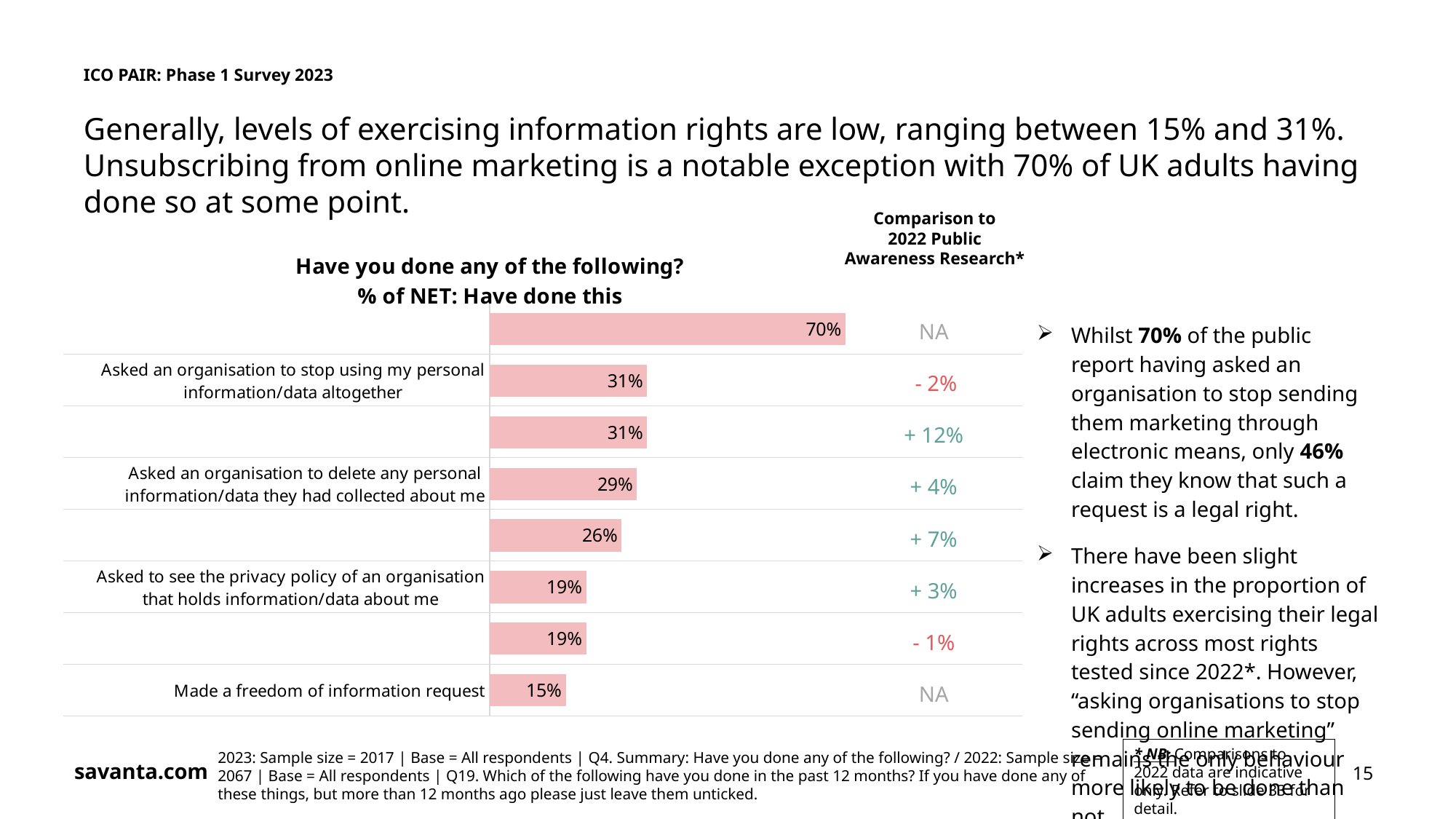
What is the title of the chart? Have you done any of the following? % of NET: Have done this What is the difference between the value for asking an organisation to stop using personal data altogether and the value for asking an organisation to delete personal data? 2% What kind of chart is shown on the slide? Bar chart Which is larger: the value for asking to see an organisation's privacy policy or the value for making a freedom of information request? Asked to see the privacy policy of an organisation that holds information/data about me What is the comparison to 2022 Public Awareness Research shown for asking an organisation to delete personal information/data? + 4% What is the highest value shown on any bar in the chart? 70% What percentage of respondents said they had asked an organisation to delete any personal information/data it had collected about them? 29% Which labelled category has the lowest value in the chart? Made a freedom of information request How many bars are plotted in the chart? 8 What percentage of respondents said they had asked an organisation to stop using their personal information/data altogether? 31% What percentage of respondents said they had asked to see the privacy policy of an organisation that holds information/data about them? 19% What percentage of respondents said they had made a freedom of information request? 15%